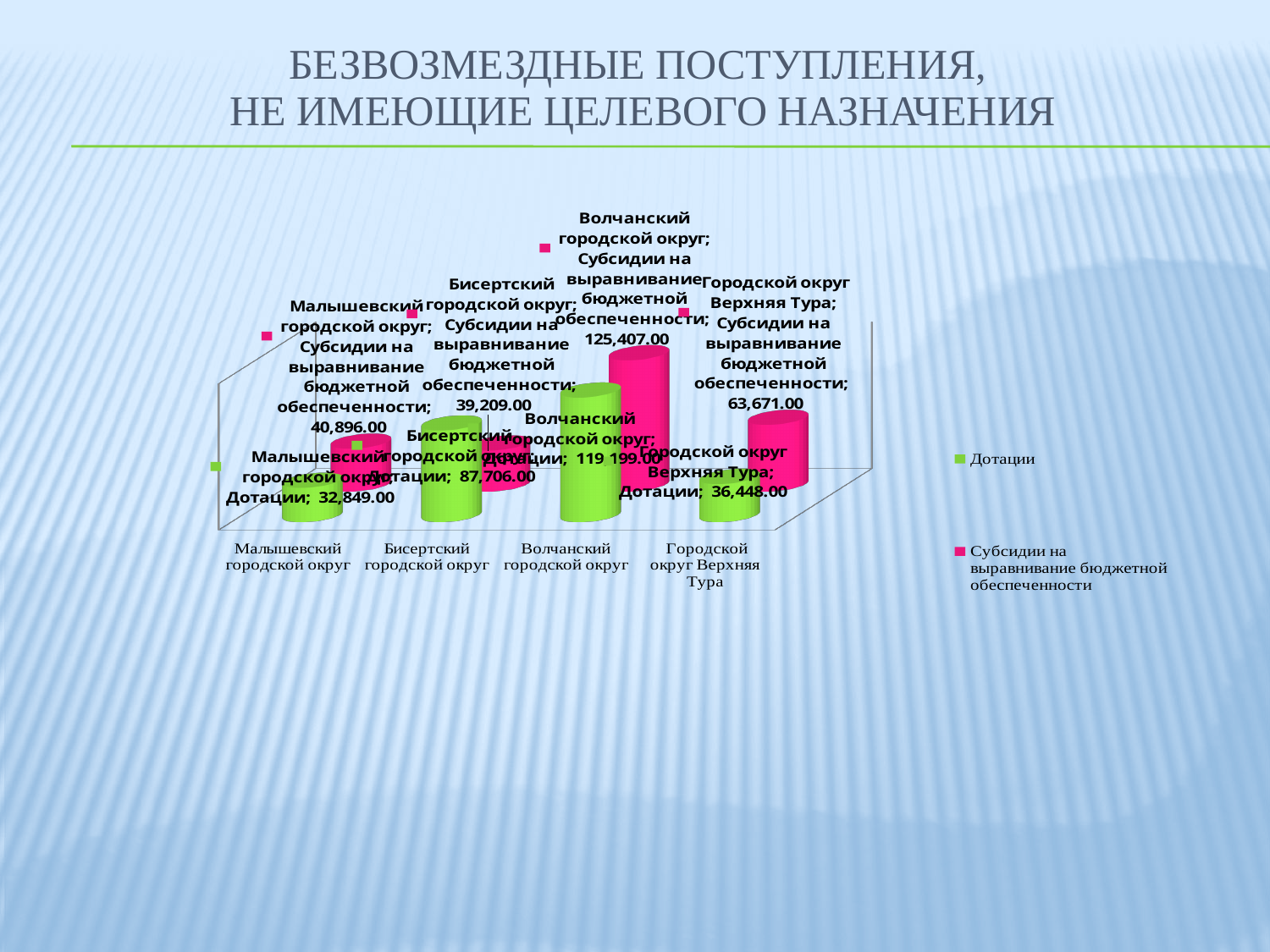
What is the difference between Субсидии на выравнивание бюджетной обеспеченности and Дотации for Городской округ Верхняя Тура? 27,223.00 What is the value of Дотации for Волчанский городской округ? 119,199.00 Which category has the highest value of Субсидии на выравнивание бюджетной обеспеченности? Волчанский городской округ What is the value of Субсидии на выравнивание бюджетной обеспеченности for Городской округ Верхняя Тура? 63,671.00 How many series does the legend list? 2 For Бисертский городской округ, which is larger: Дотации or Субсидии на выравнивание бюджетной обеспеченности? Дотации What is the value of Дотации for Малышевский городской округ? 32,849.00 What type of chart is shown on the slide? Bar chart What is the value of Субсидии на выравнивание бюджетной обеспеченности for Бисертский городской округ? 39,209.00 Which category has the highest value of Дотации? Волчанский городской округ Which category has the lowest value of Дотации? Малышевский городской округ How many categories (городские округа) are shown on the x axis? 4